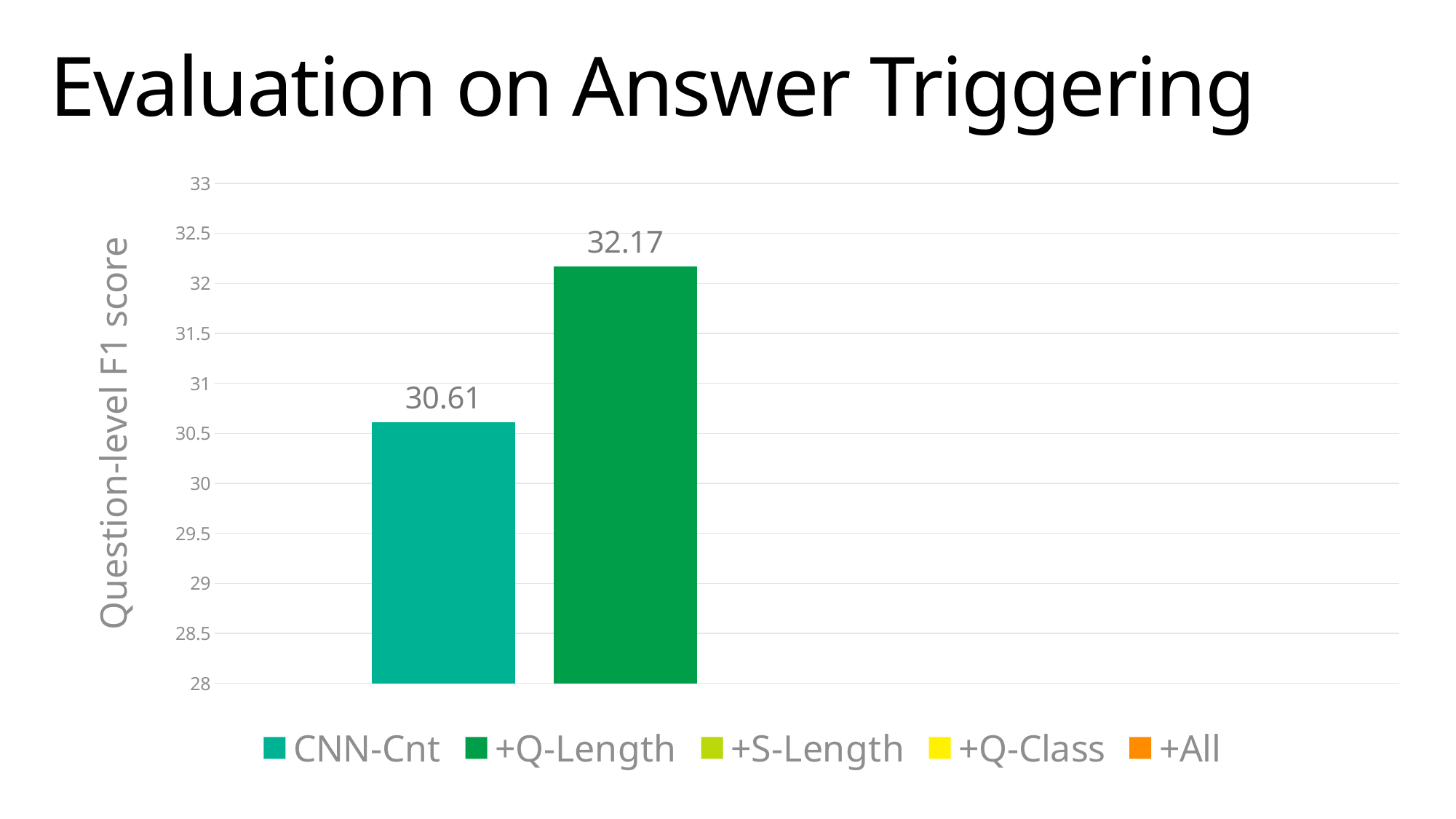
Which plotted series has the lowest Question-level F1 score? CNN-Cnt Which has a higher F1 score, CNN-Cnt or +Q-Length? +Q-Length Which plotted series has the highest Question-level F1 score? +Q-Length What is the Question-level F1 score for +Q-Length? 32.17 What is the Question-level F1 score for CNN-Cnt? 30.61 What is the label of the vertical axis? Question-level F1 score How many series does the legend list? 5 Is the value for CNN-Cnt greater or less than 31? less What is the difference between the F1 scores of +Q-Length and CNN-Cnt? 1.56 Is the value for +Q-Length greater or less than 32? greater How many bars are plotted on the chart? 2 What kind of chart is shown on the slide? Bar chart